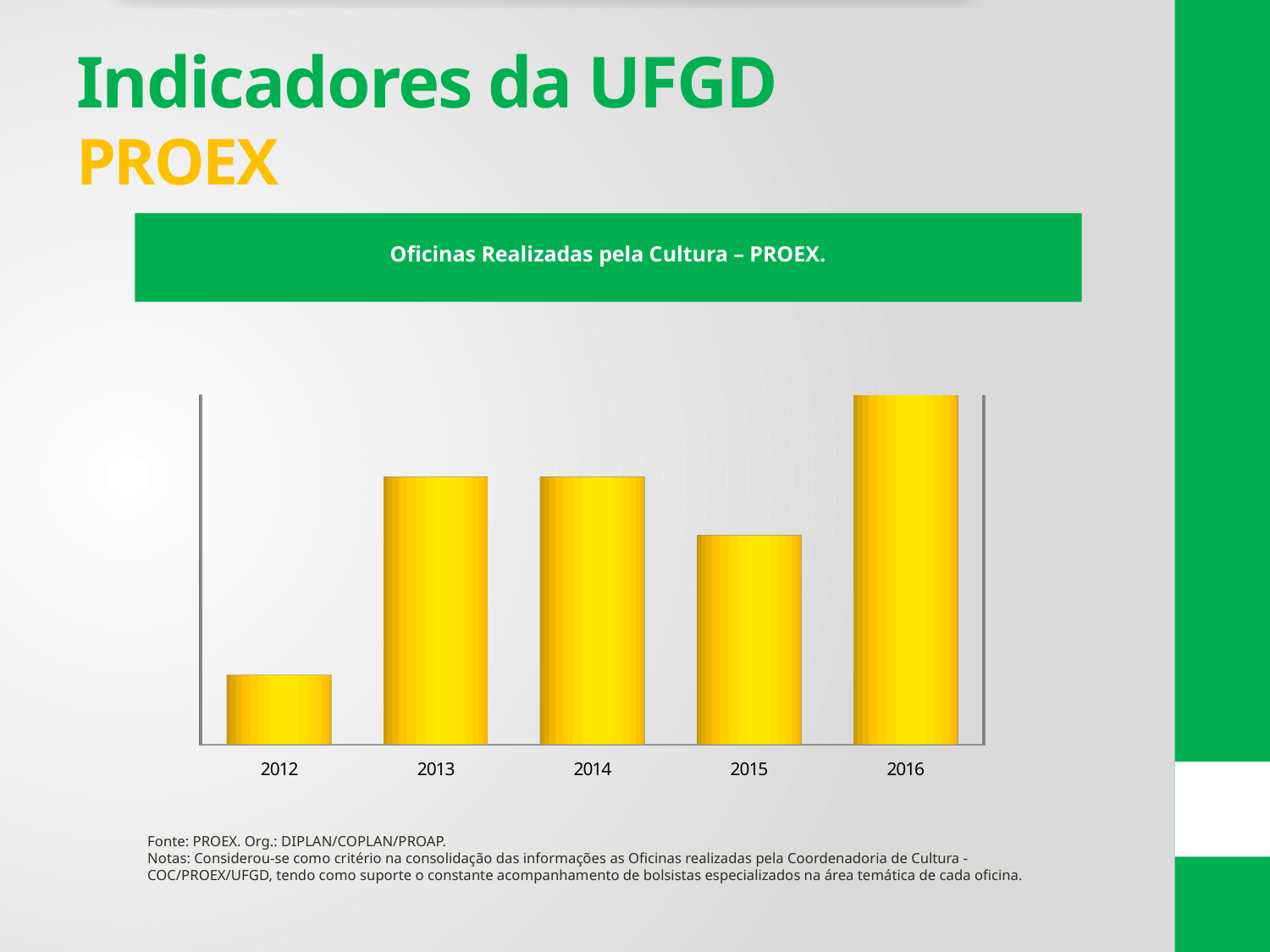
Which is larger, the value for 2013 or the value for 2015? 2013 What colour are the bars in the chart? yellow How many years are shown on the x axis of the chart? 5 Does the value rise or fall from 2015 to 2016? rise Which is larger, the value for 2016 or the value for 2014? 2016 Does the value rise or fall from 2012 to 2013? rise Does the value rise or fall from 2014 to 2015? fall What is the title of the chart? Oficinas Realizadas pela Cultura – PROEX. Which year has the highest bar in the chart? 2016 What kind of chart is shown on the slide? bar chart Which year has the lowest bar in the chart? 2012 Which is larger, the value for 2012 or the value for 2015? 2015